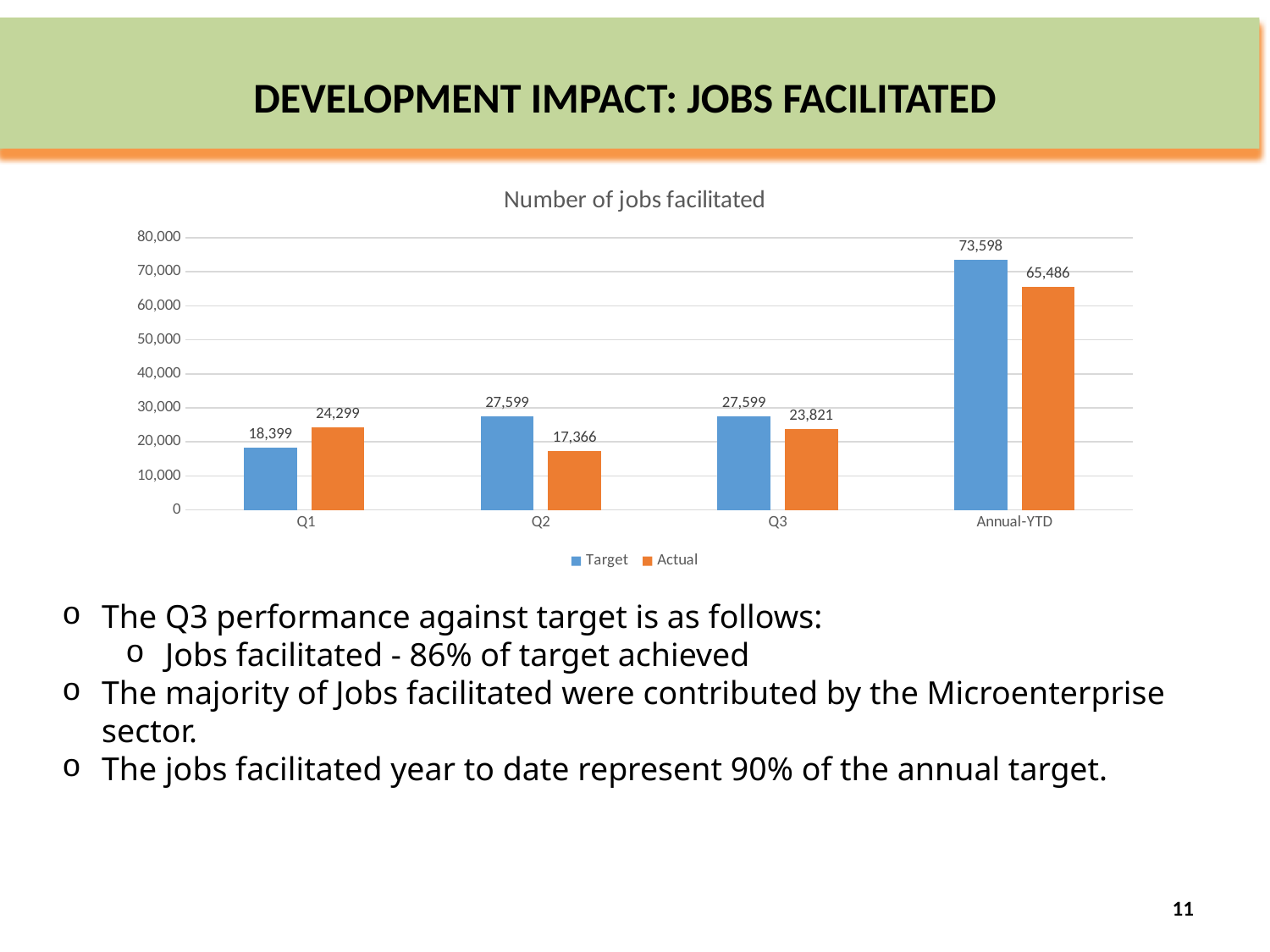
What kind of chart is shown on the slide? Bar chart What is the title of the chart? Number of jobs facilitated What is the Actual value for Q2? 17,366 Which is larger for Q1, the Target or the Actual value? Actual How many series does the legend list? 2 Which category has the lowest Actual value? Q2 Is the Target value for Annual-YTD greater or less than 70,000? greater What is the Target value for Q1? 18,399 Which category has the highest Target value? Annual-YTD What is the Actual value for Annual-YTD? 65,486 What is the difference between the Target and Actual values for Q3? 3,778 How many categories are shown on the x axis? 4